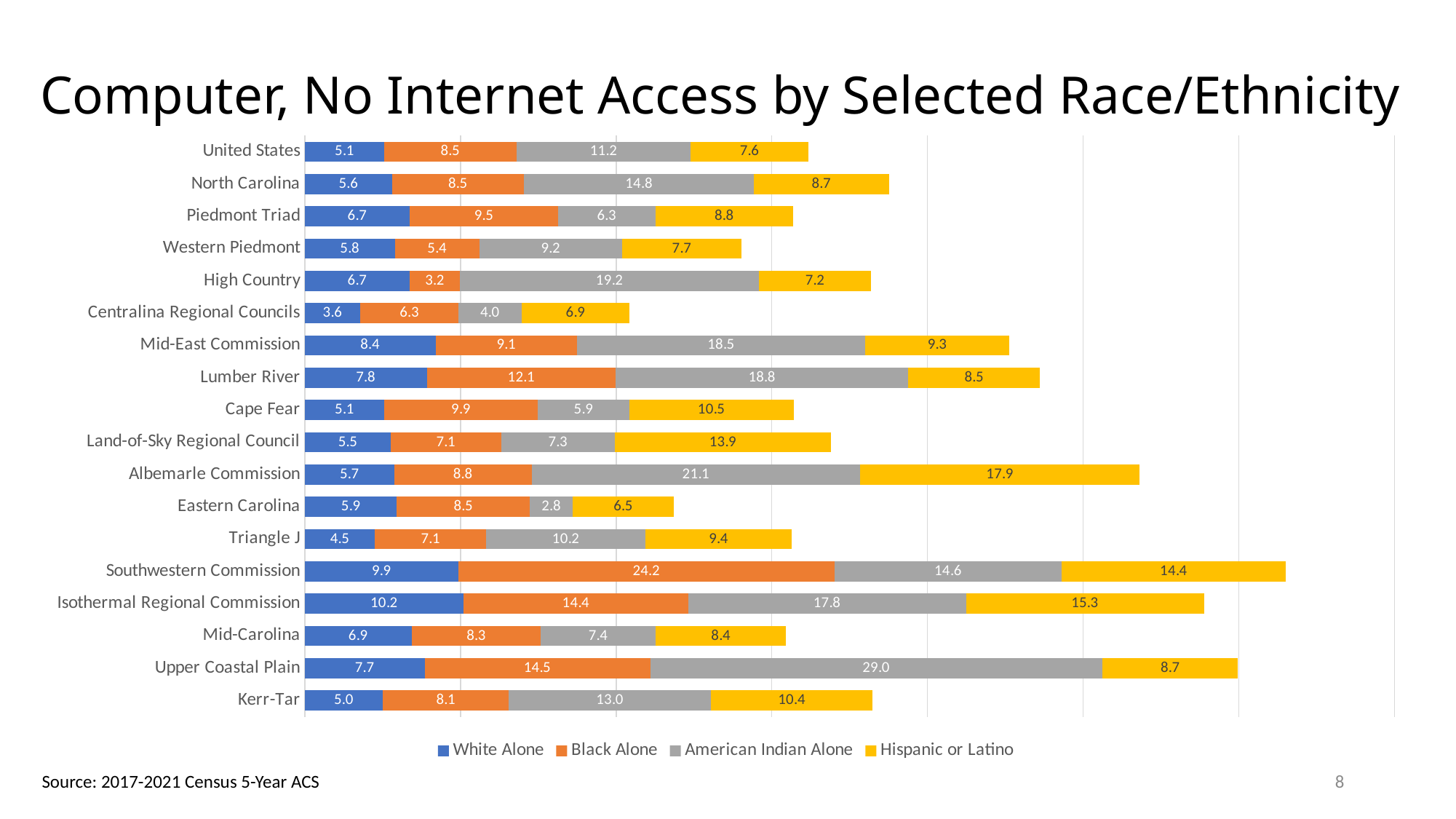
Which category has the highest White Alone value? Isothermal Regional Commission What is the Hispanic or Latino value for Land-of-Sky Regional Council? 13.9 What kind of chart is shown? Stacked bar chart Which category has the highest Hispanic or Latino value? Albemarle Commission What is the difference between the American Indian Alone values for North Carolina and the United States? 3.6 What is the Black Alone value for Southwestern Commission? 24.2 How many categories are shown on the y axis? 18 What is the American Indian Alone value for Upper Coastal Plain? 29.0 What is the total of the stacked bar for Centralina Regional Councils? 20.8 How many series does the legend list? 4 Which category has the lowest American Indian Alone value? Eastern Carolina Which is larger, the Black Alone value for Lumber River or for Mid-East Commission? Lumber River